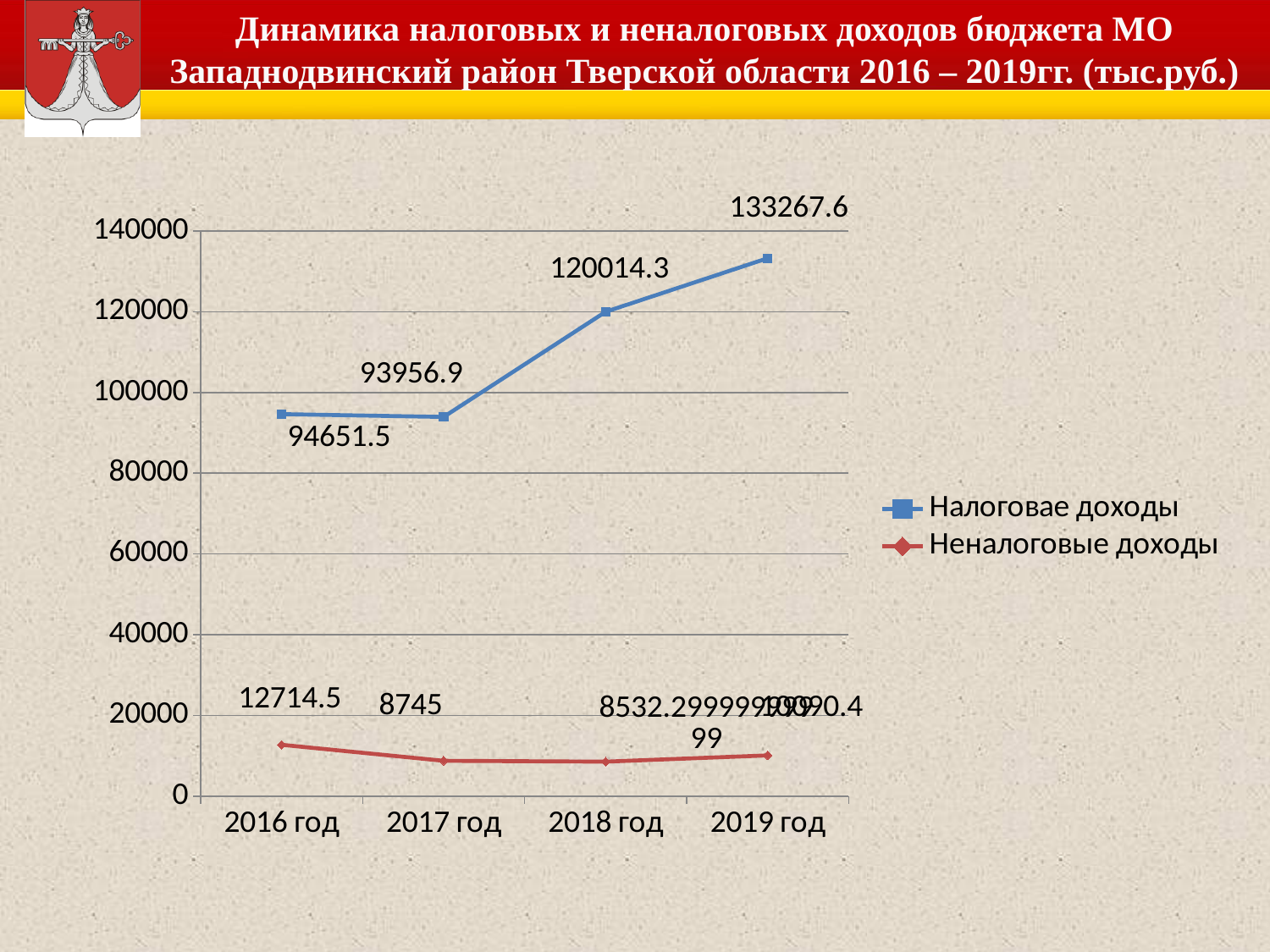
In which year is Налоговае доходы highest? 2019 год Is the value of Налоговае доходы for 2018 год greater or less than 100000? greater Does Налоговае доходы rise or fall from 2017 год to 2019 год? rise What is the difference between Налоговае доходы in 2019 год and 2018 год? 13253.3 What is the value of Неналоговые доходы for 2016 год? 12714.5 What kind of chart is shown on the slide? line chart What is the value of Налоговае доходы for 2019 год? 133267.6 How many years are plotted along the x axis? 4 What is the value of Неналоговые доходы for 2017 год? 8745 In which year is Налоговае доходы lowest? 2017 год How many series does the legend list? 2 What is the value of Налоговае доходы for 2016 год? 94651.5